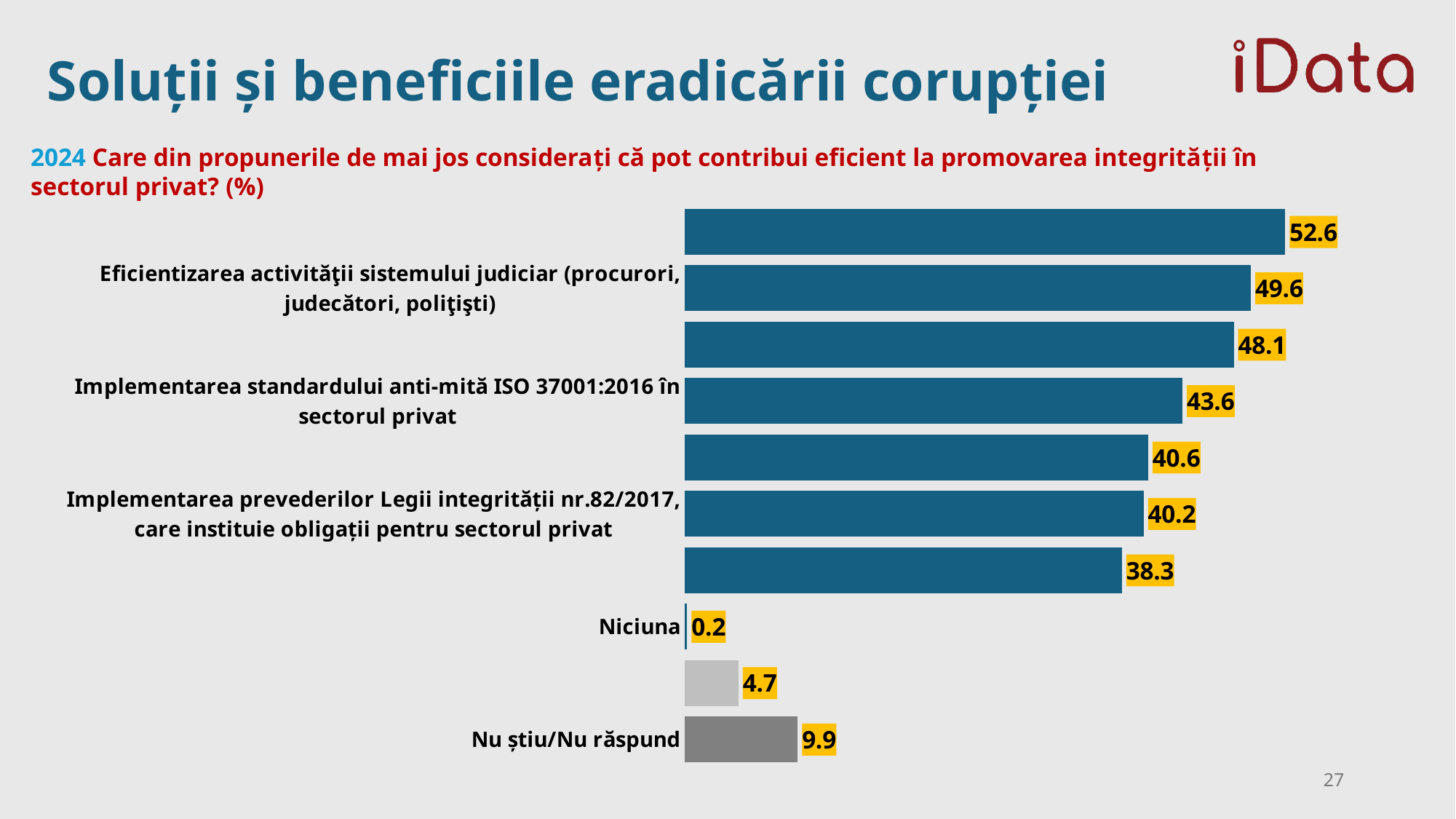
What kind of chart is shown on the slide? Bar chart What value is shown for "Implementarea prevederilor Legii integrității nr.82/2017, care instituie obligații pentru sectorul privat"? 40.2 Which category has the lowest value in the chart? Niciuna What value is shown for "Nu știu/Nu răspund"? 9.9 What is the difference between the values for "Eficientizarea activităţii sistemului judiciar" and "Implementarea standardului anti-mită ISO 37001:2016 în sectorul privat"? 6.0 What value is shown for "Eficientizarea activităţii sistemului judiciar (procurori, judecători, poliţişti)"? 49.6 How many bars are plotted in the chart? 10 What is the highest value shown on any bar in the chart? 52.6 What value is shown for "Niciuna"? 0.2 Which is larger: the value for "Nu știu/Nu răspund" or the value for "Niciuna"? Nu știu/Nu răspund What is the difference between the values for "Implementarea standardului anti-mită ISO 37001:2016 în sectorul privat" and "Implementarea prevederilor Legii integrității nr.82/2017"? 3.4 What value is shown for "Implementarea standardului anti-mită ISO 37001:2016 în sectorul privat"? 43.6